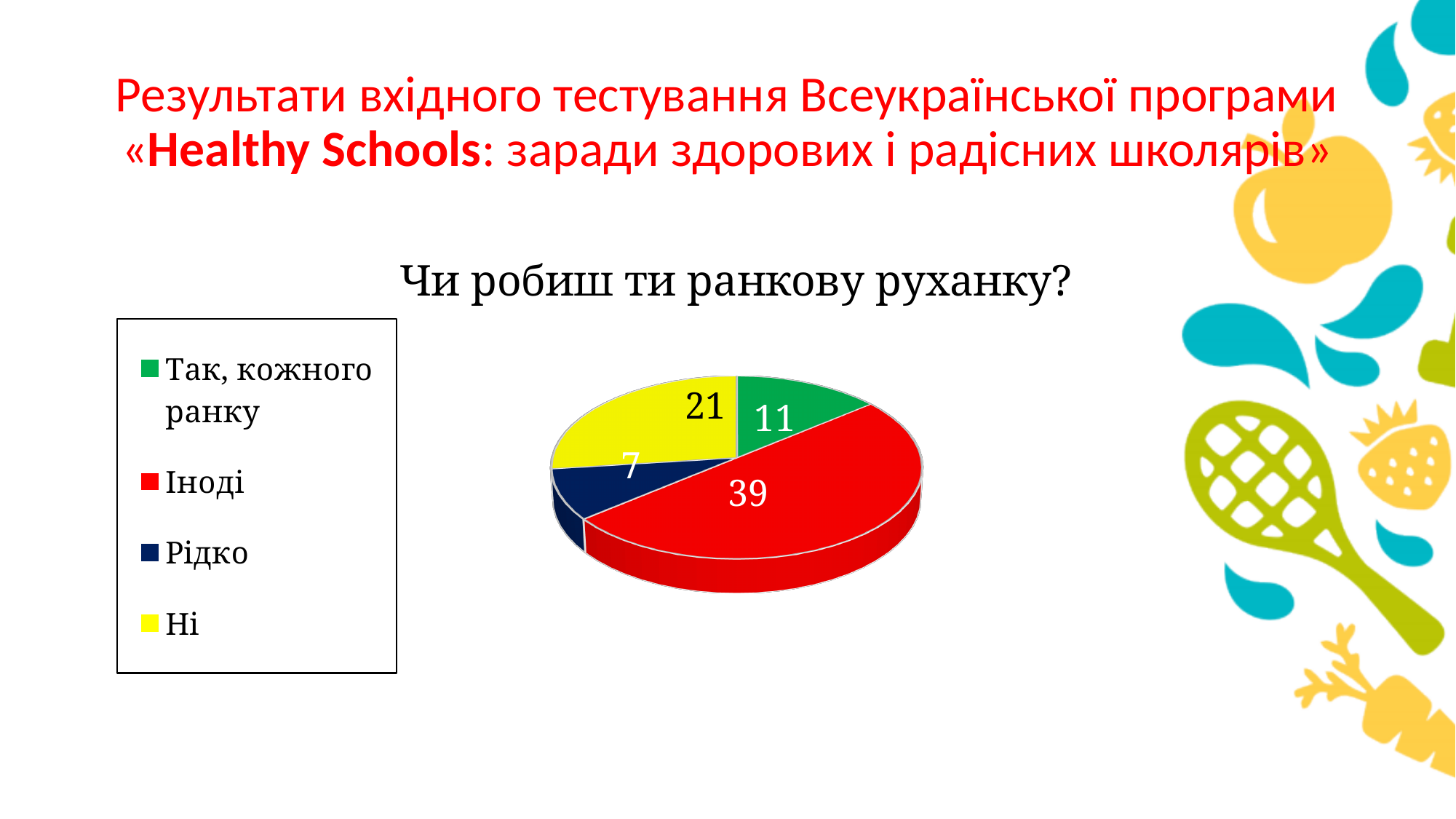
What is the title of the pie chart? Чи робиш ти ранкову руханку? How many categories does the pie chart have? 4 What is the value for "Іноді" in the pie chart? 39 Which is larger, the value for "Ні" or the value for "Так, кожного ранку"? Ні Which category has the smallest slice in the pie chart? Рідко What is the value for "Так, кожного ранку" in the pie chart? 11 What share of the pie does "Іноді" represent? 50% What is the difference between the values for "Іноді" and "Ні"? 18 What is the value for "Рідко" in the pie chart? 7 Which category has the largest slice in the pie chart? Іноді What type of chart is shown on the slide? pie chart What is the value for "Ні" in the pie chart? 21